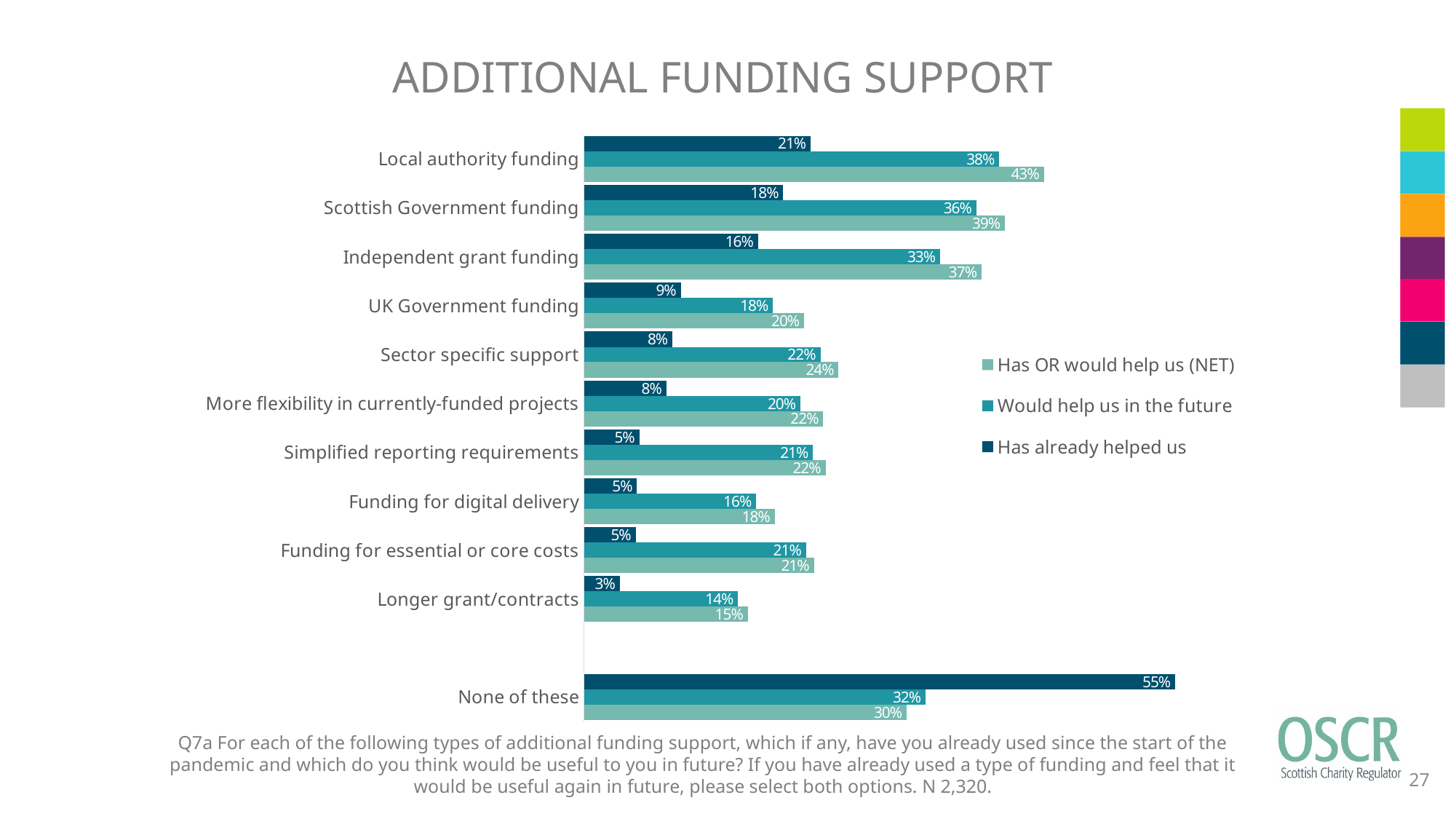
Excluding 'None of these', which category has the highest 'Has OR would help us (NET)' value? Local authority funding What is the title of the chart? ADDITIONAL FUNDING SUPPORT What is the 'Has OR would help us (NET)' value for Sector specific support? 24% How many series does the legend list? 3 Which category has the lowest 'Has already helped us' value? Longer grant/contracts What is the 'Has already helped us' value for Local authority funding? 21% What is the 'Has already helped us' value for None of these? 55% Which is larger: the 'Would help us in the future' value for UK Government funding or for Sector specific support? Sector specific support What is the difference between the 'Has OR would help us (NET)' values for Local authority funding and Scottish Government funding? 4% What is the 'Would help us in the future' value for Independent grant funding? 33% What type of chart is shown on the slide? Bar chart How many categories are shown on the chart? 11